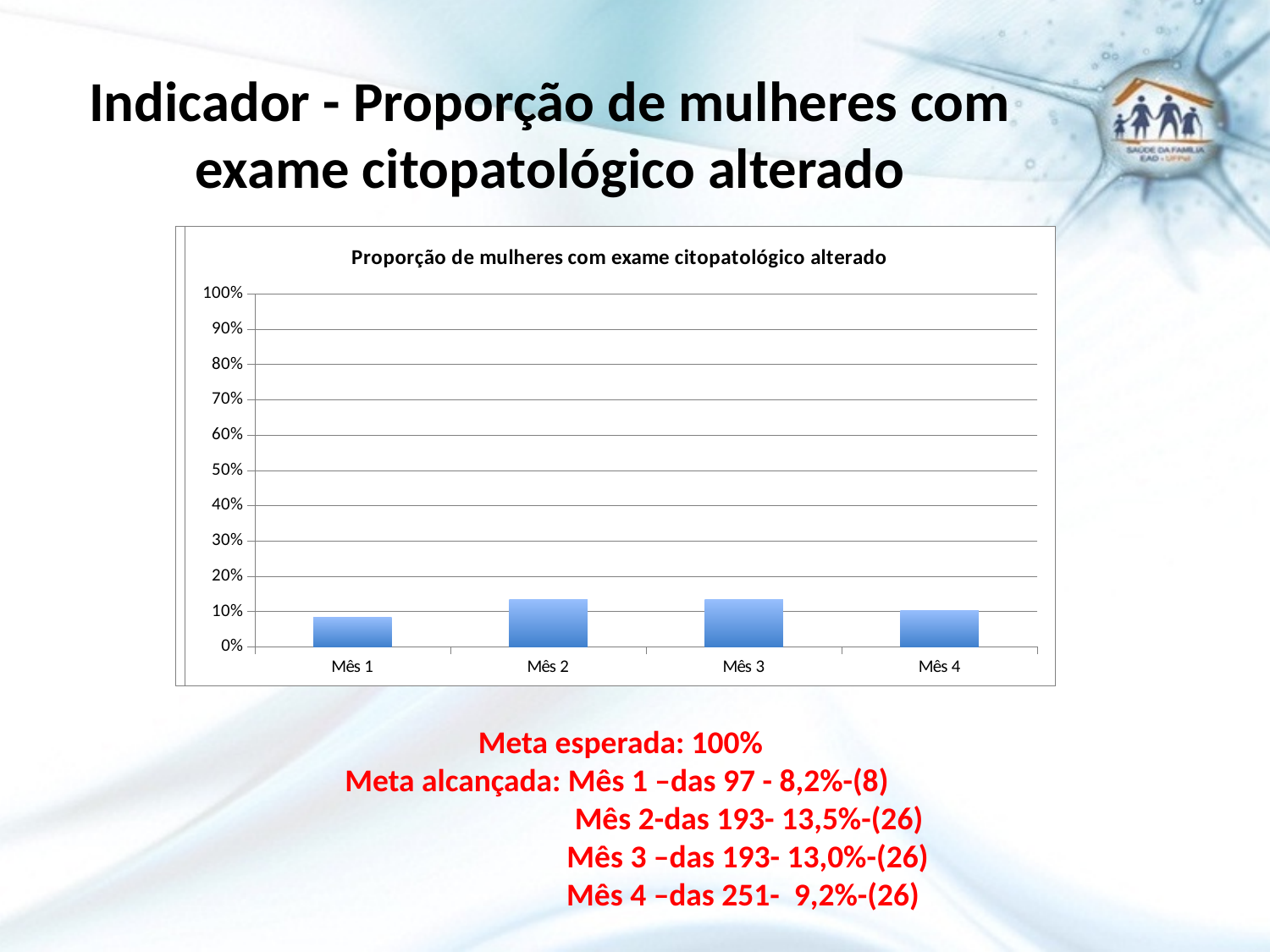
What is the highest value shown on the y axis of the chart? 100% Is the value for Mês 2 greater or less than 10%? greater Is the value for Mês 3 greater or less than 20%? less What is the title of the chart? Proporção de mulheres com exame citopatológico alterado According to the text on the slide, what proportion was reached in Mês 4? 9,2% According to the text on the slide, what proportion was reached in Mês 1? 8,2% How many months (categories) are plotted on the x axis of the chart? 4 Which is larger, the value for Mês 1 or the value for Mês 2? Mês 2 Which is larger, the value for Mês 3 or the value for Mês 4? Mês 3 Is the value for Mês 1 greater or less than 10%? less What type of chart is shown on the slide? bar chart